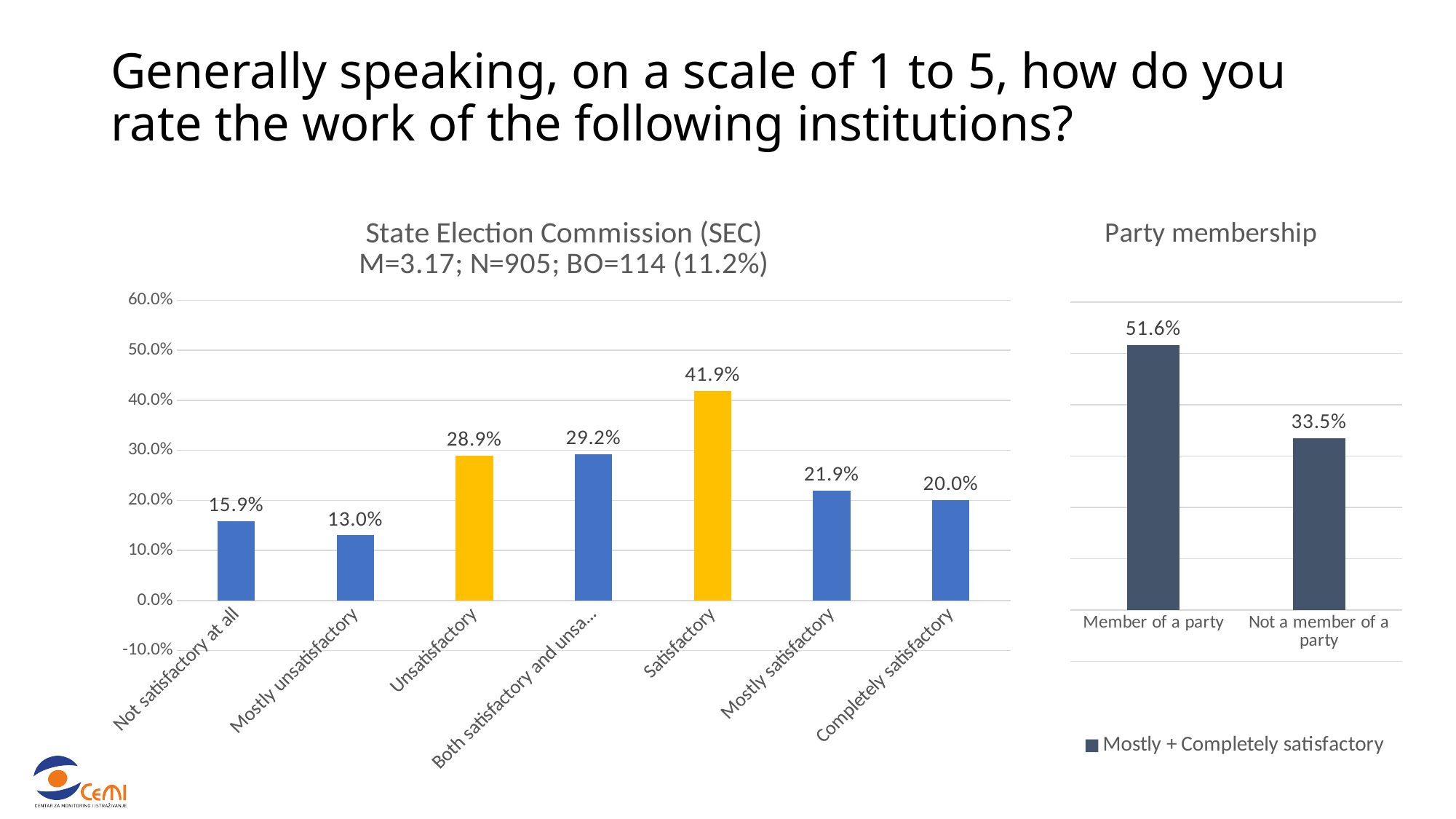
What kind of chart is the State Election Commission (SEC) chart? Bar chart In the State Election Commission (SEC) chart, which category has the highest value? Satisfactory In the Party membership chart, what is the difference between Member of a party and Not a member of a party? 18.1% In the State Election Commission (SEC) chart, what is the value for Mostly unsatisfactory? 13.0% In the State Election Commission (SEC) chart, which is larger: Mostly satisfactory or Completely satisfactory? Mostly satisfactory How many categories are shown in the State Election Commission (SEC) chart? 7 In the State Election Commission (SEC) chart, which category has the lowest value? Mostly unsatisfactory In the State Election Commission (SEC) chart, what is the difference between Satisfactory and Unsatisfactory? 13.0% In the Party membership chart, what is the value for Member of a party? 51.6% What series does the legend of the Party membership chart list? Mostly + Completely satisfactory In the State Election Commission (SEC) chart, what is the value for Satisfactory? 41.9% In the Party membership chart, which category has the higher value? Member of a party